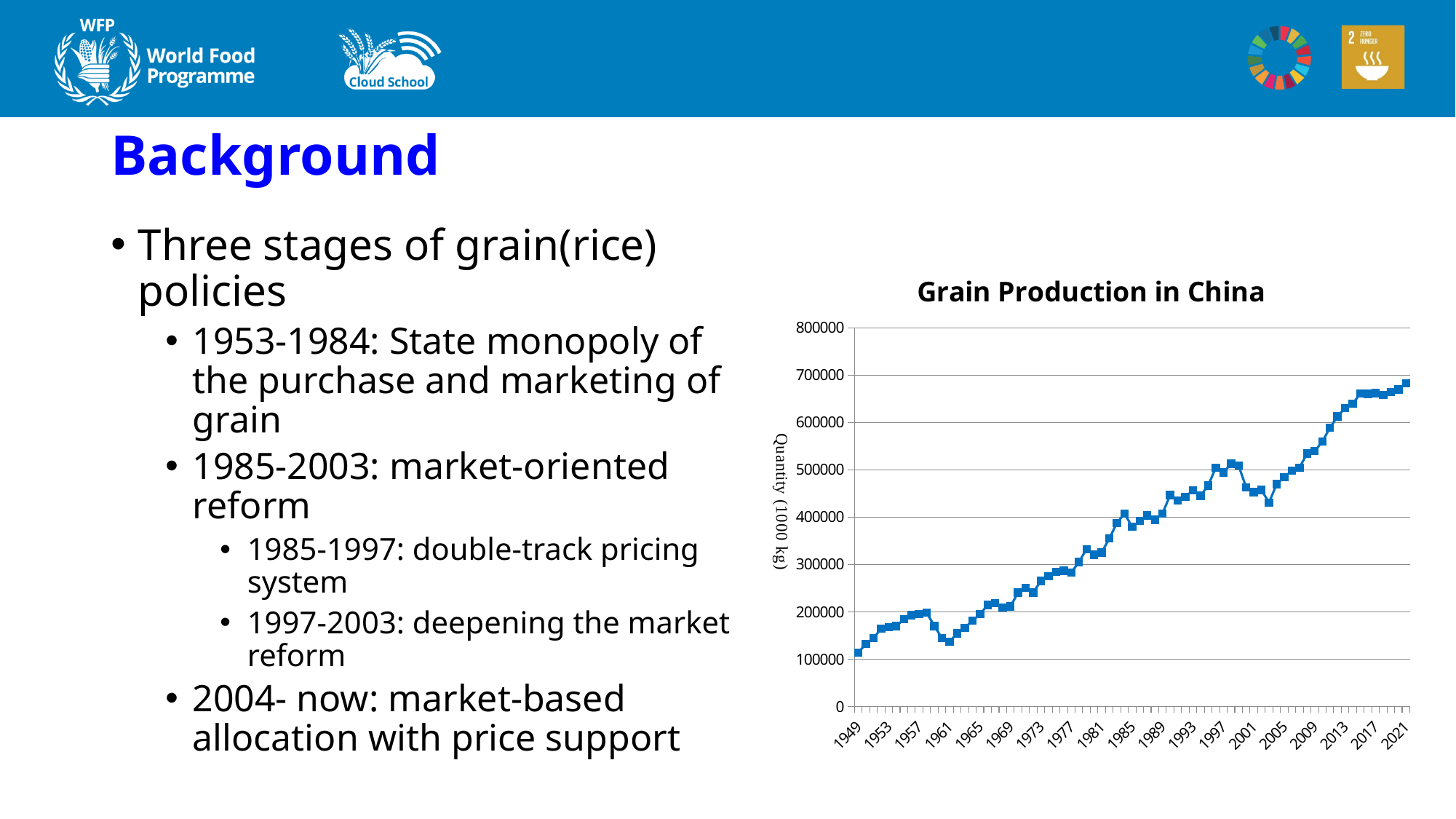
What is the label on the vertical axis of the chart? Quantity (1000 kg) Which year has the larger value, 1957 or 1961? 1957 Which year has the lowest value in the chart? 1949 What is the title of the chart? Grain Production in China Is the value for 1977 greater or less than 300000? less Which year has the highest value in the chart? 2021 Is the value for 1949 greater or less than 200000? less Is the value for 2021 greater or less than 600000? greater Between 1998 and 2003, do the values in the chart rise or fall? fall What kind of chart is shown on the slide? line chart Overall, do the values in the chart rise or fall from 1949 to 2021? rise